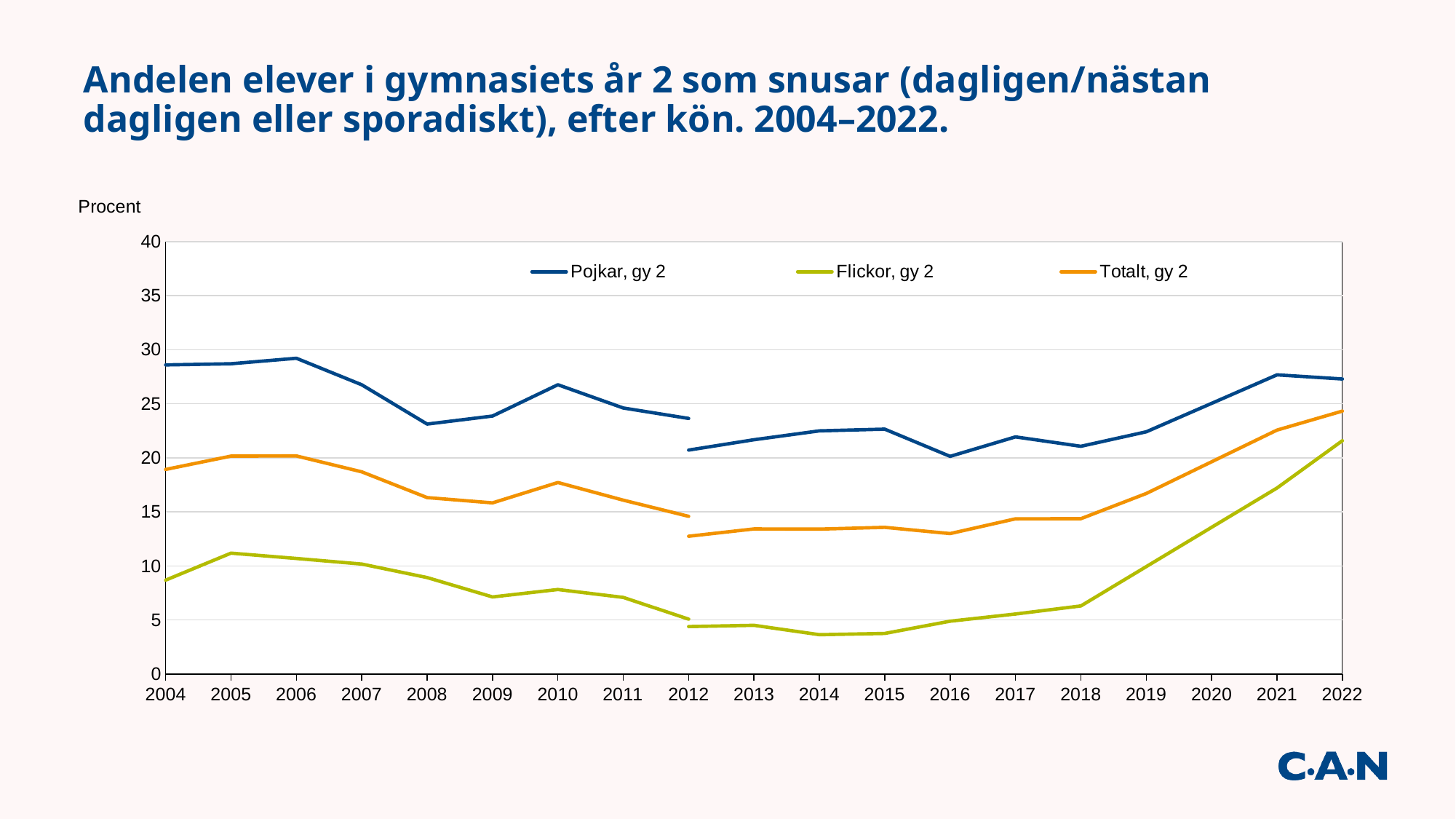
In which year does Pojkar, gy 2 reach its highest value? 2006 How many years are labelled on the x axis? 19 How many series does the legend list? 3 Is the value for Totalt, gy 2 in 2004 greater or less than 15? greater What is the label on the vertical axis? Procent What kind of chart is shown on the slide? line chart In which year does Flickor, gy 2 reach its highest value? 2022 Is the value for Pojkar, gy 2 in 2006 greater or less than 25? greater Is the value for Totalt, gy 2 in 2022 greater or less than 20? greater Does the Flickor, gy 2 line rise or fall from 2018 to 2022? rise In 2010, which series has the larger value: Pojkar, gy 2 or Flickor, gy 2? Pojkar, gy 2